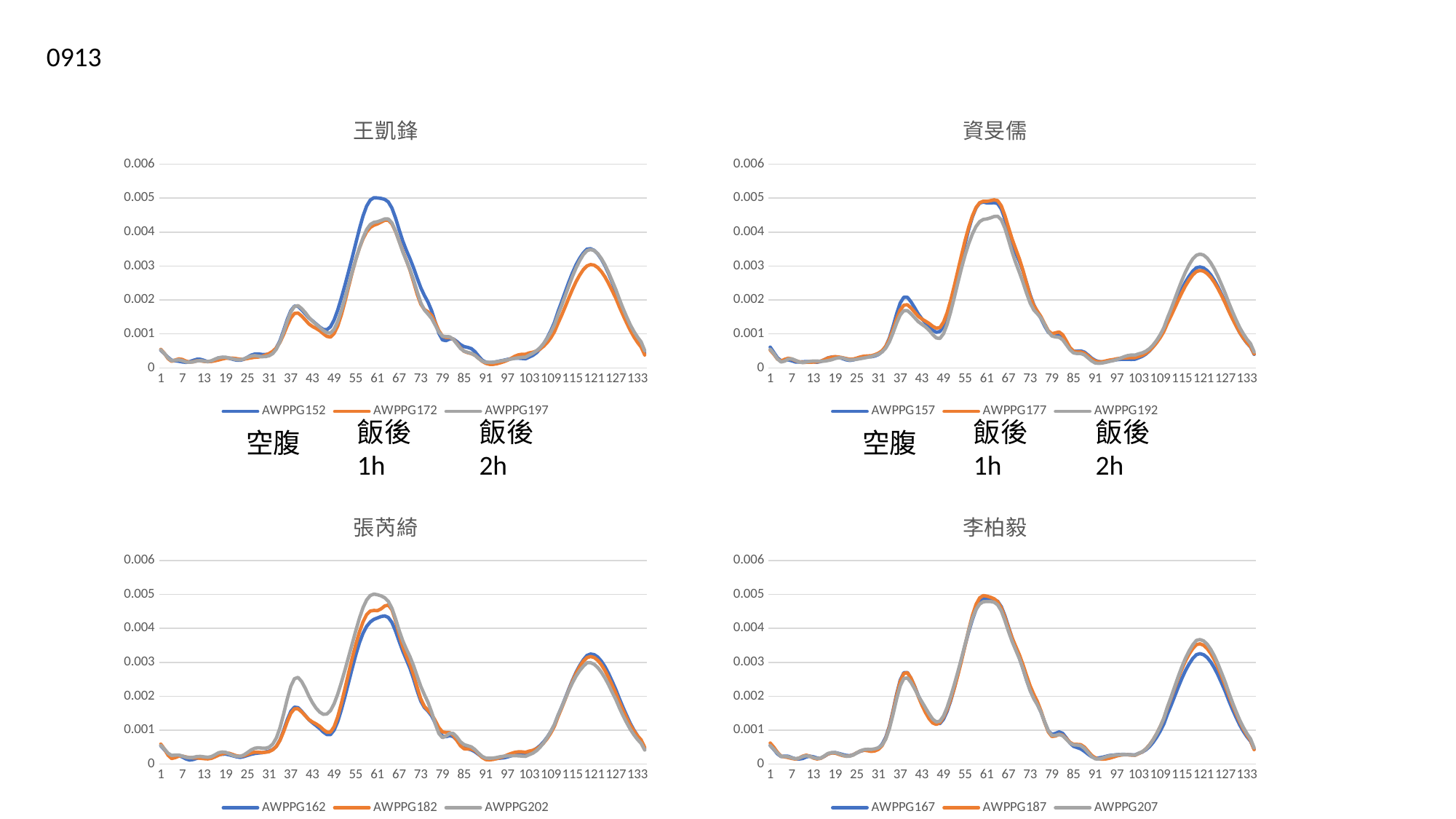
How many charts are shown on the slide? 4 In the chart titled 王凱鋒, how many series does the legend list? 3 In the chart titled 張芮綺, is the peak value of AWPPG162 near x=61 greater or less than 0.005? less In the chart titled 李柏毅, is the peak value of AWPPG187 near x=61 greater or less than 0.004? greater In the chart titled 張芮綺, at x=37, which series is larger, AWPPG202 or AWPPG162? AWPPG202 In the chart titled 王凱鋒, is the peak value of AWPPG172 near x=121 greater or less than 0.004? less In the chart titled 王凱鋒, at x=61, which series is larger, AWPPG152 or AWPPG197? AWPPG152 What kind of chart is the top-left chart titled 王凱鋒? line chart In the chart titled 李柏毅, what are the three series names in the legend? AWPPG167, AWPPG187, AWPPG207